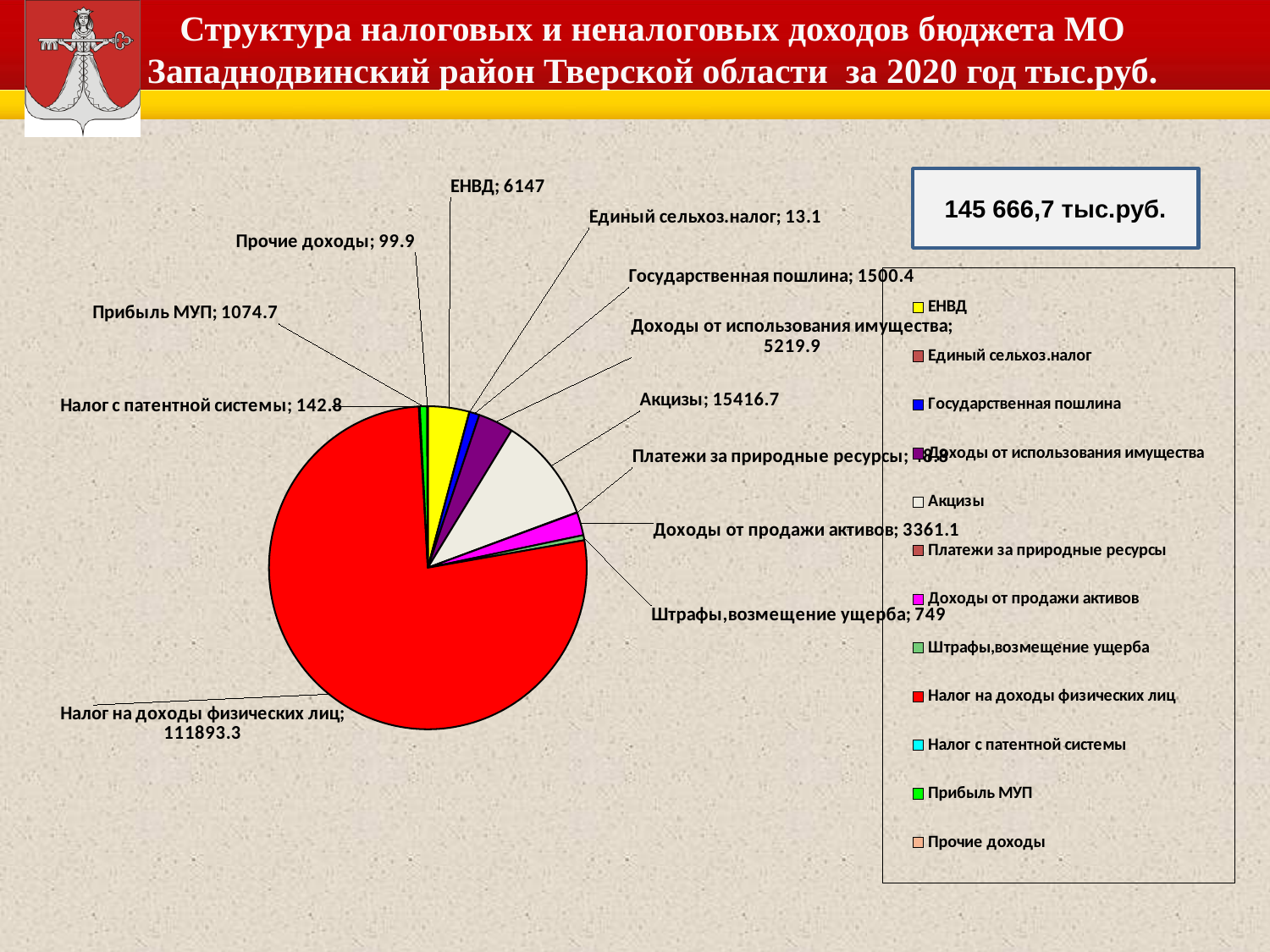
What kind of chart is shown on the slide? Pie chart Which is larger, Штрафы,возмещение ущерба or Государственная пошлина? Государственная пошлина What is the difference between the values for Акцизы and ЕНВД? 9269.7 What is the value for Налог на доходы физических лиц? 111893.3 Which category has the largest slice of the pie? Налог на доходы физических лиц What is the value for Акцизы? 15416.7 Which category has the smallest value shown on the chart? Единый сельхоз.налог How many entries does the legend list? 12 What is the difference between Доходы от использования имущества and Доходы от продажи активов? 1858.8 What total amount is shown in the box at the top right of the slide? 145 666,7 тыс.руб. What is the value for Прибыль МУП? 1074.7 What is the value for Государственная пошлина? 1500.4